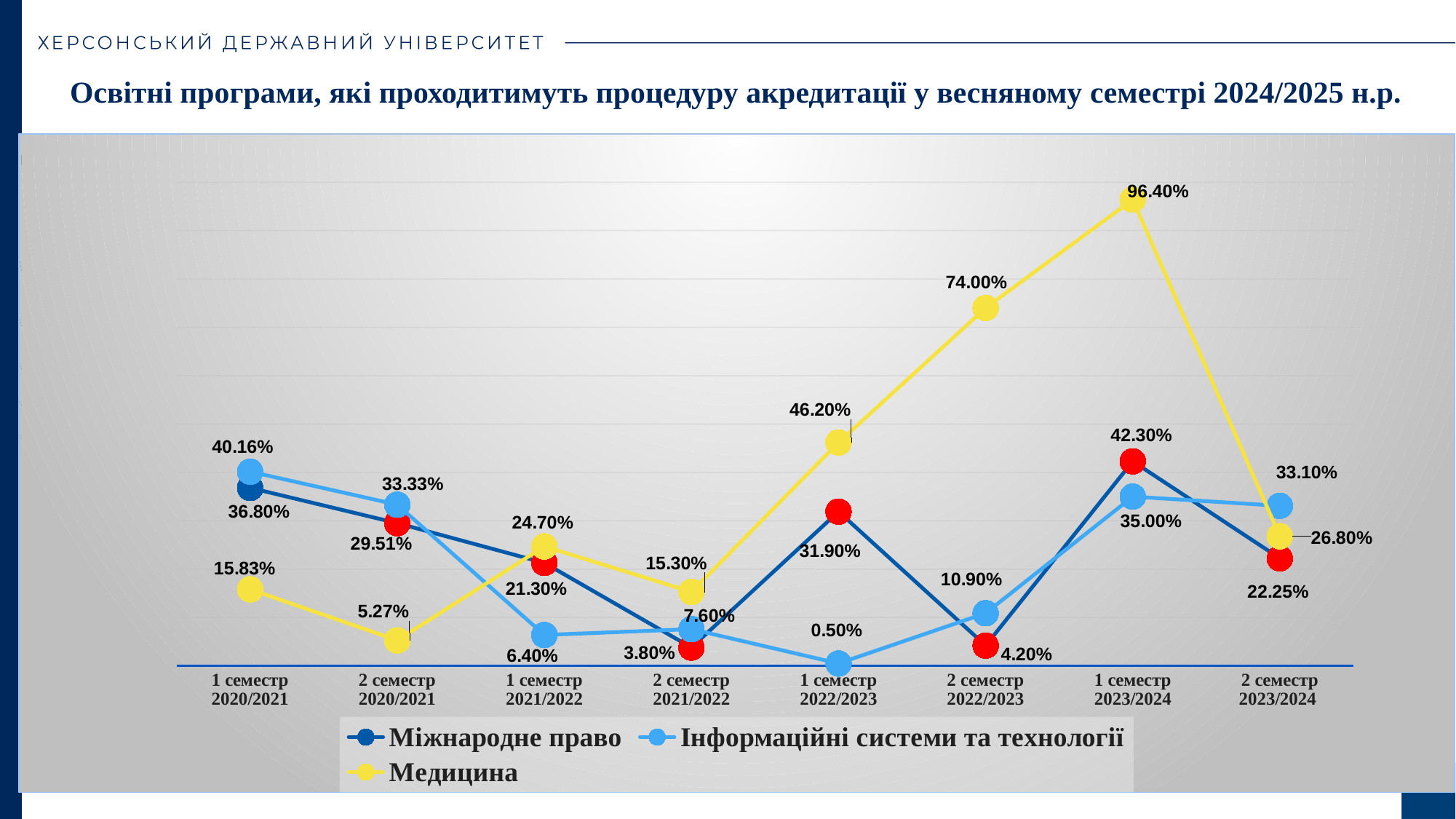
How many series does the legend list? 3 What is the value for Міжнародне право in 2 семестр 2023/2024? 22.25% What is the difference between the Медицина values in 1 семестр 2023/2024 and 2 семестр 2022/2023? 22.40% In which semester does Медицина reach its highest value? 1 семестр 2023/2024 What is the value for Інформаційні системи та технології in 1 семестр 2020/2021? 40.16% What type of chart is shown on the slide? line chart Which series is drawn in yellow? Медицина Does the Медицина series rise or fall from 2 семестр 2021/2022 to 1 семестр 2023/2024? rise What is the value for Медицина in 1 семестр 2023/2024? 96.40% In which semester does Інформаційні системи та технології have its lowest value? 1 семестр 2022/2023 How many semester categories are shown on the x axis? 8 Which series has the larger value in 1 семестр 2022/2023: Медицина or Міжнародне право? Медицина